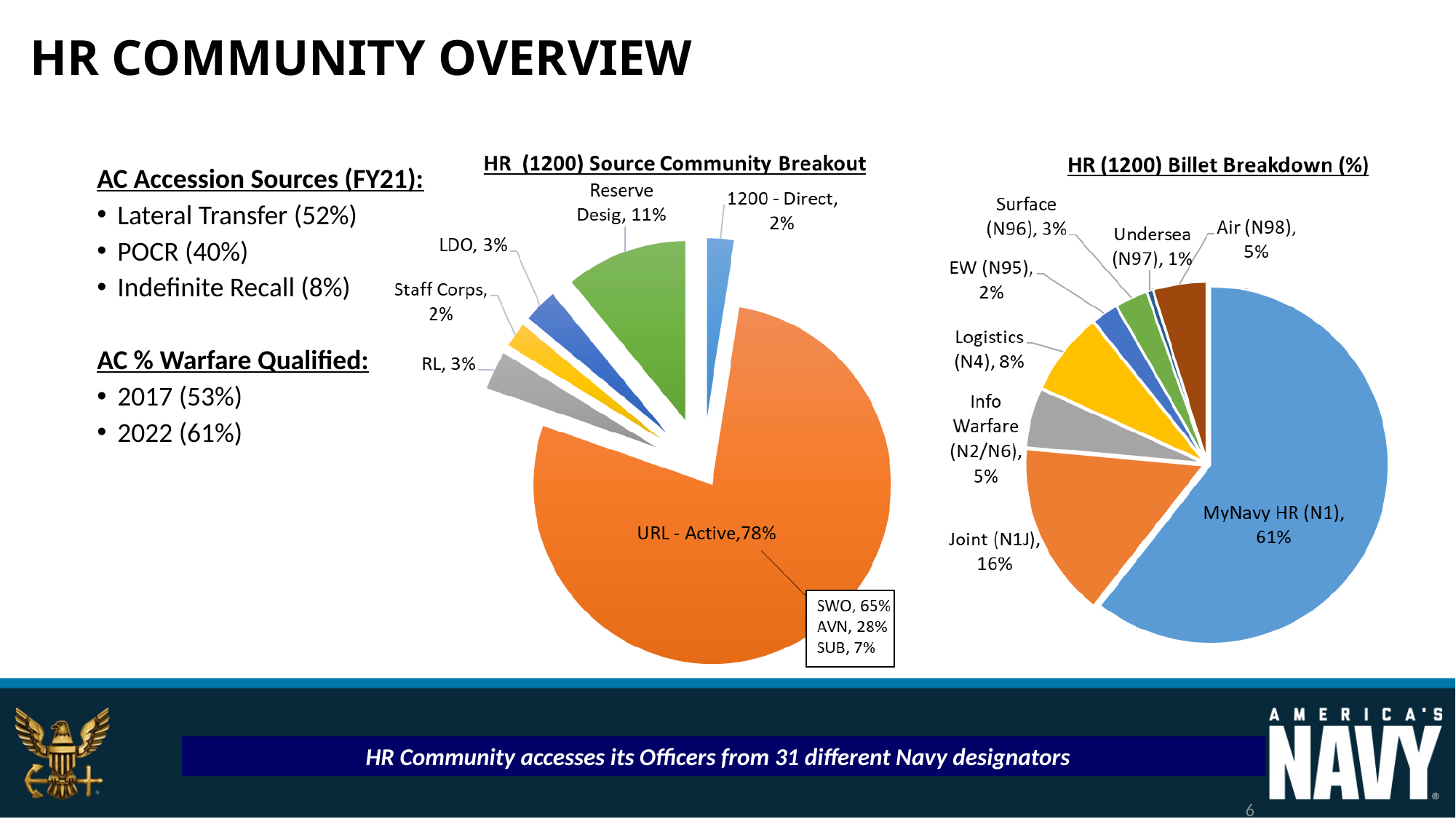
In the HR (1200) Billet Breakdown (%) chart, what is the value for MyNavy HR (N1)? 61% What kind of chart is the HR (1200) Source Community Breakout? Pie chart In the HR (1200) Source Community Breakout chart, how many slices does the pie have? 6 In the HR (1200) Source Community Breakout chart, what is the difference between URL - Active and Reserve Desig? 67% In the HR (1200) Source Community Breakout chart, what share does URL - Active hold? 78% In the HR (1200) Billet Breakdown (%) chart, how many slices does the pie have? 8 In the HR (1200) Billet Breakdown (%) chart, what is the difference between MyNavy HR (N1) and Joint (N1J)? 45% In the HR (1200) Billet Breakdown (%) chart, which is larger, Logistics (N4) or Air (N98)? Logistics (N4) In the HR (1200) Billet Breakdown (%) chart, which category has the smallest slice? Undersea (N97) In the HR (1200) Billet Breakdown (%) chart, what is the value for Joint (N1J)? 16% In the HR (1200) Source Community Breakout chart, which category has the largest slice? URL - Active In the HR (1200) Source Community Breakout chart, what is the value for Reserve Desig? 11%